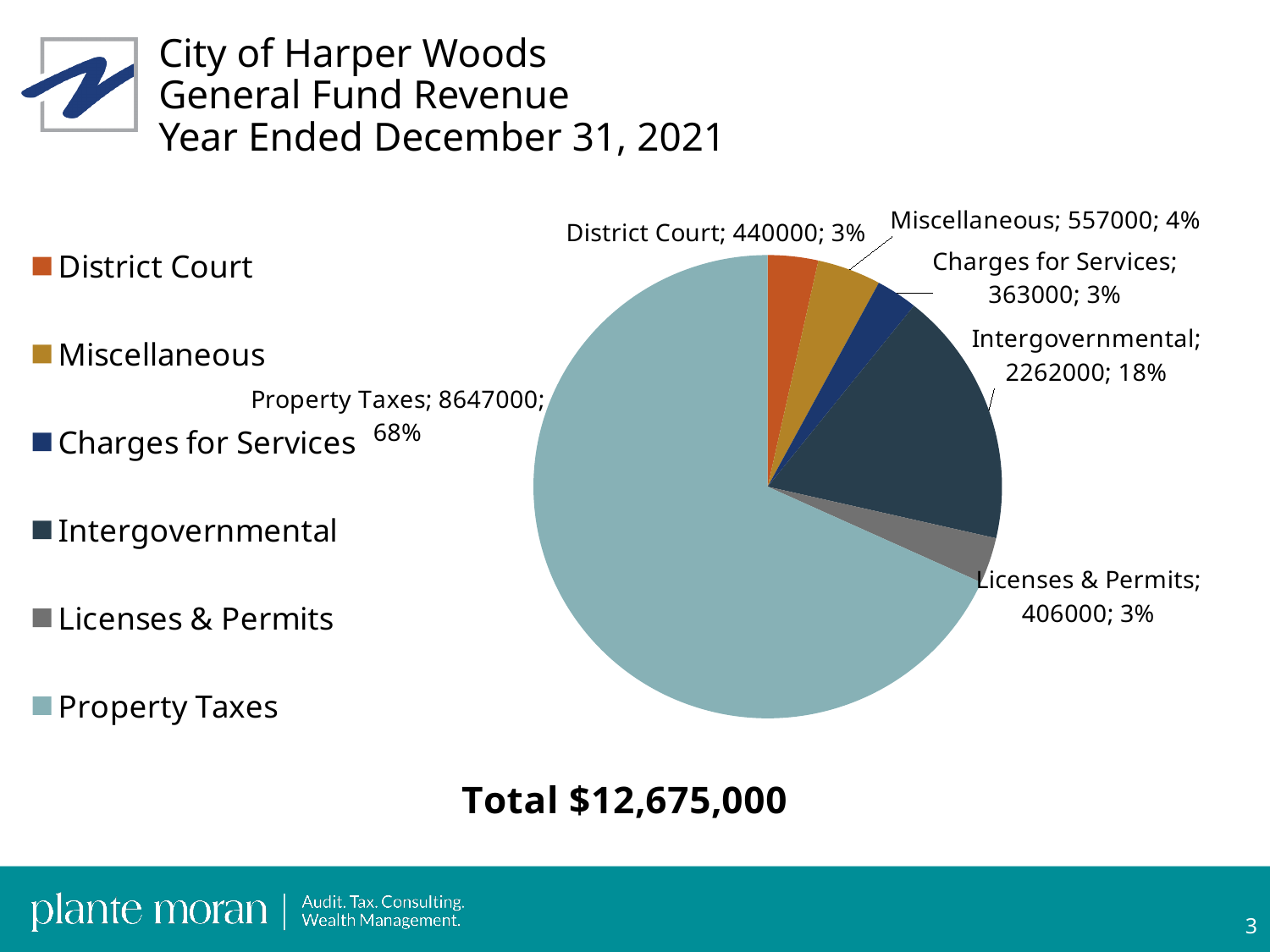
What share of the pie does Intergovernmental represent? 18% Which is larger, the value for Miscellaneous or the value for Licenses & Permits? Miscellaneous What is the value for Miscellaneous? 557000 Which category has the smallest value? Charges for Services Which category has the largest slice of the pie? Property Taxes What kind of chart is shown on the slide? Pie chart What is the value for Intergovernmental? 2262000 What share of the pie does Property Taxes represent? 68% What is the difference between the values for Intergovernmental and District Court? 1822000 How many categories does the legend list? 6 What is the value for Licenses & Permits? 406000 What is the value for Property Taxes? 8647000